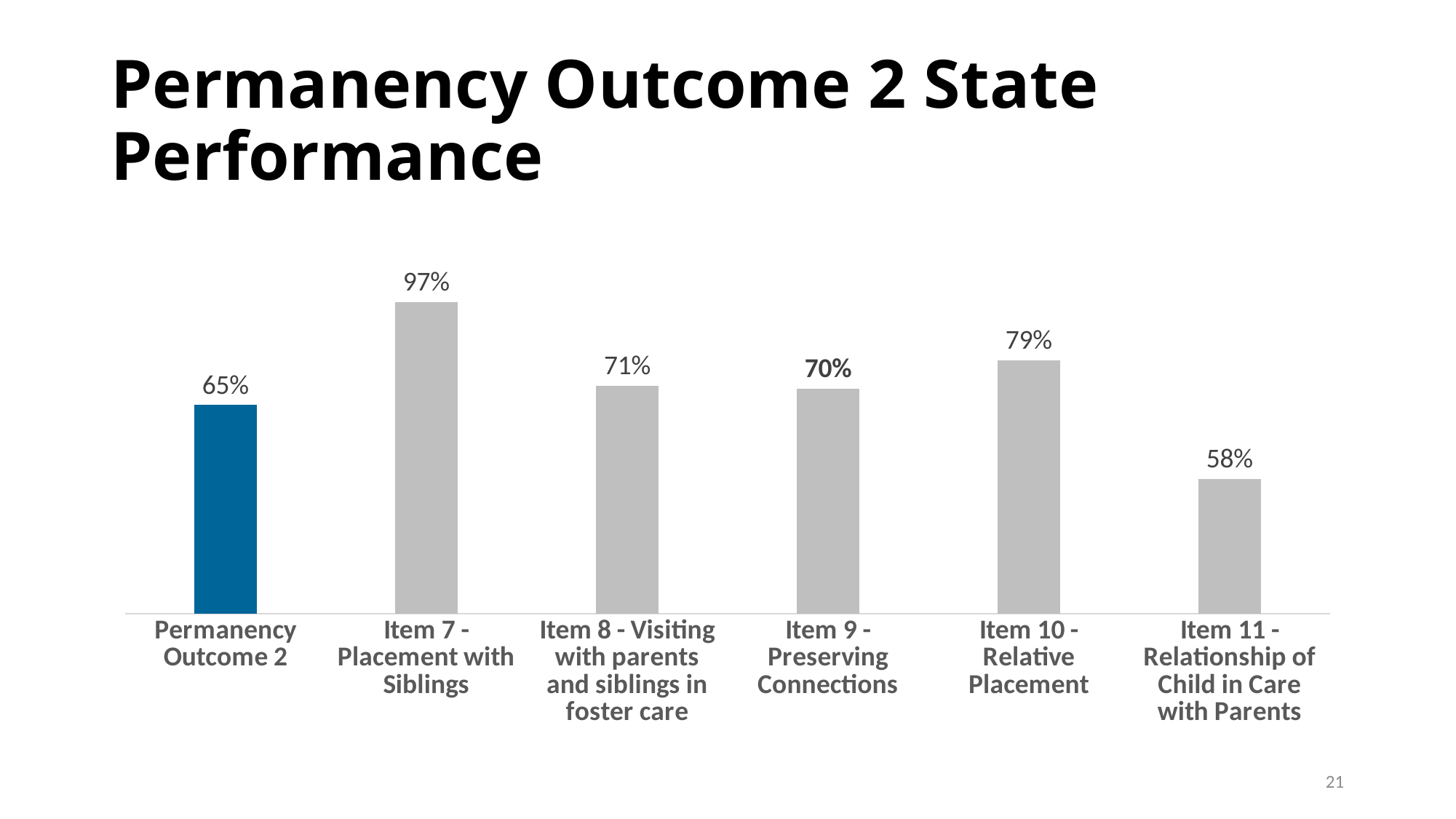
What is the value for Item 7 - Placement with Siblings? 97% Which bar is coloured blue rather than grey? Permanency Outcome 2 Which category has the highest value? Item 7 - Placement with Siblings What is the difference between the values for Item 10 - Relative Placement and Permanency Outcome 2? 14% What is the value for Item 11 - Relationship of Child in Care with Parents? 58% Which is larger, the value for Item 10 - Relative Placement or the value for Item 8 - Visiting with parents and siblings in foster care? Item 10 - Relative Placement How many bars are shown in the chart? 6 What is the value for Permanency Outcome 2? 65% What is the difference between the values for Item 7 - Placement with Siblings and Item 11 - Relationship of Child in Care with Parents? 39% What is the value for Item 9 - Preserving Connections? 70% Which category has the lowest value? Item 11 - Relationship of Child in Care with Parents What kind of chart is shown on the slide? Bar chart